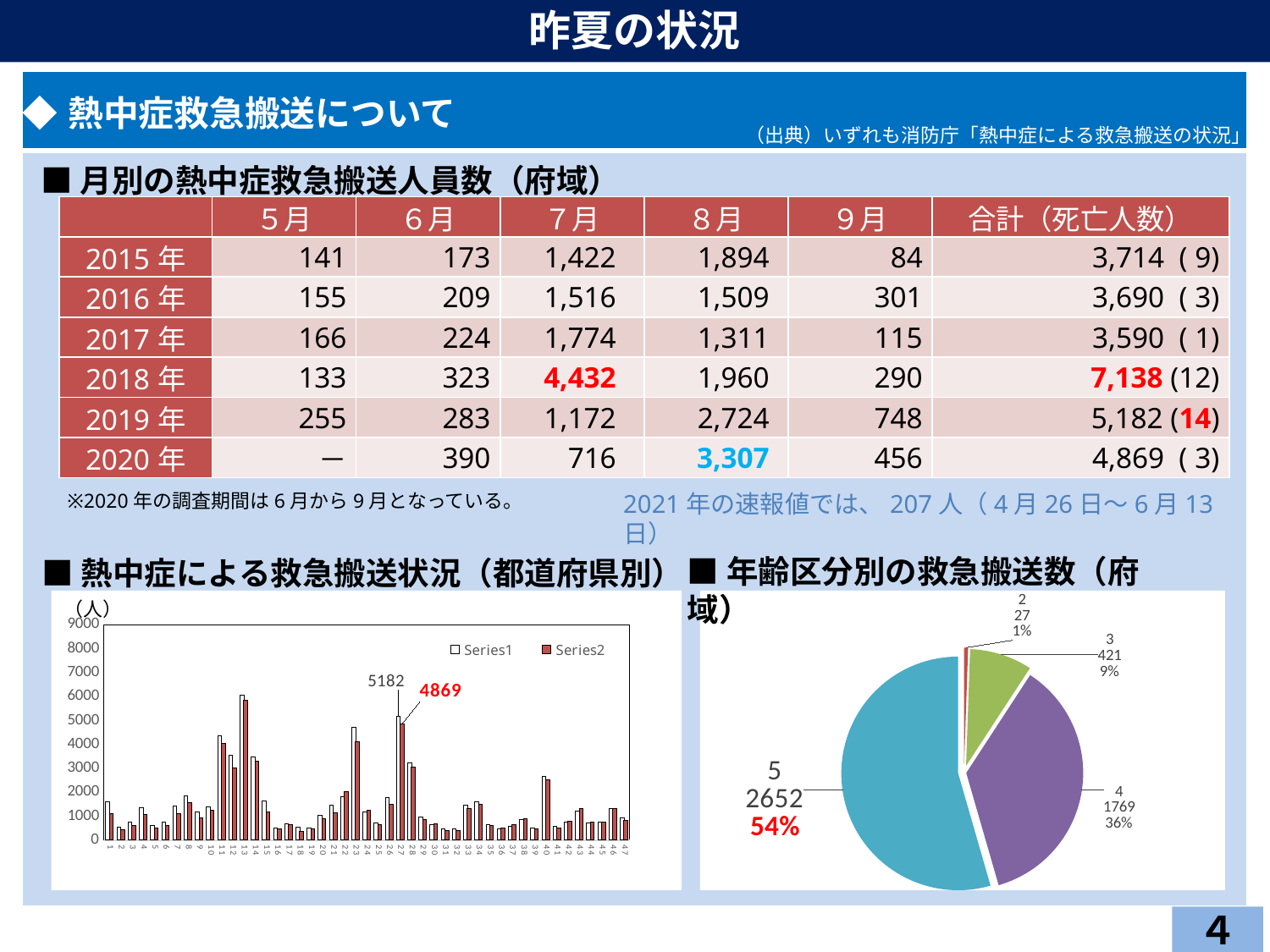
What kind of chart is the chart titled 年齢区分別の救急搬送数（府域）? pie chart In the pie chart 年齢区分別の救急搬送数（府域）, what is the value for category 3? 421 In the bar chart 熱中症による救急搬送状況（都道府県別）, how many series does the legend list? 2 In the bar chart 熱中症による救急搬送状況（都道府県別）, what is the labelled value of Series2 at category 27? 4869 What kind of chart is the chart titled 熱中症による救急搬送状況（都道府県別）? bar chart In the bar chart 熱中症による救急搬送状況（都道府県別）, which series has the larger value at category 27, Series1 or Series2? Series1 In the pie chart 年齢区分別の救急搬送数（府域）, which category has the largest slice? 5 In the bar chart 熱中症による救急搬送状況（都道府県別）, what is the difference between the two labelled values at category 27 (5182 and 4869)? 313 In the bar chart 熱中症による救急搬送状況（都道府県別）, is the Series1 value at category 13 greater or less than 5000? greater In the bar chart 熱中症による救急搬送状況（都道府県別）, what is the labelled value of Series1 at category 27? 5182 In the pie chart 年齢区分別の救急搬送数（府域）, what share of the pie does category 4 represent? 36% In the pie chart 年齢区分別の救急搬送数（府域）, what is the value for category 5? 2652